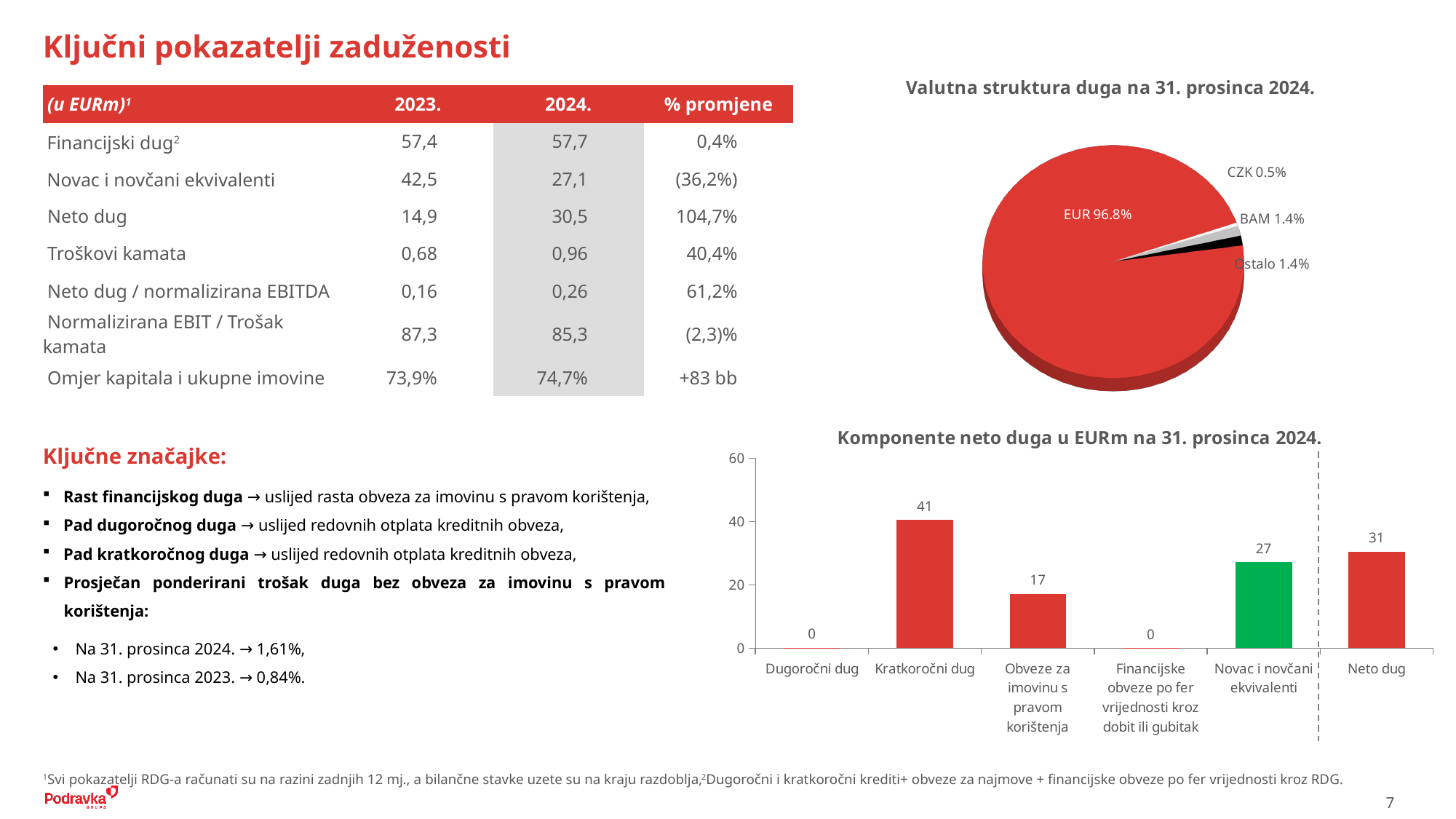
How many categories are shown in the chart 'Komponente neto duga u EURm na 31. prosinca 2024.'? 6 How many slices does the pie chart 'Valutna struktura duga na 31. prosinca 2024.' have? 4 In the pie chart 'Valutna struktura duga na 31. prosinca 2024.', what share does CZK have? 0.5% In the chart 'Komponente neto duga u EURm na 31. prosinca 2024.', what is the value for Novac i novčani ekvivalenti? 27 In the chart 'Komponente neto duga u EURm na 31. prosinca 2024.', what is the value for Neto dug? 31 In the chart 'Komponente neto duga u EURm na 31. prosinca 2024.', which category has the highest value? Kratkoročni dug In the pie chart 'Valutna struktura duga na 31. prosinca 2024.', which currency has the smallest share? CZK In the chart 'Komponente neto duga u EURm na 31. prosinca 2024.', what is the difference between Kratkoročni dug and Obveze za imovinu s pravom korištenja? 24 In the pie chart 'Valutna struktura duga na 31. prosinca 2024.', what share does EUR have? 96.8% In the chart 'Komponente neto duga u EURm na 31. prosinca 2024.', what is the value for Kratkoročni dug? 41 In the chart 'Komponente neto duga u EURm na 31. prosinca 2024.', which is larger: Novac i novčani ekvivalenti or Neto dug? Neto dug What kind of chart is 'Komponente neto duga u EURm na 31. prosinca 2024.'? Bar chart